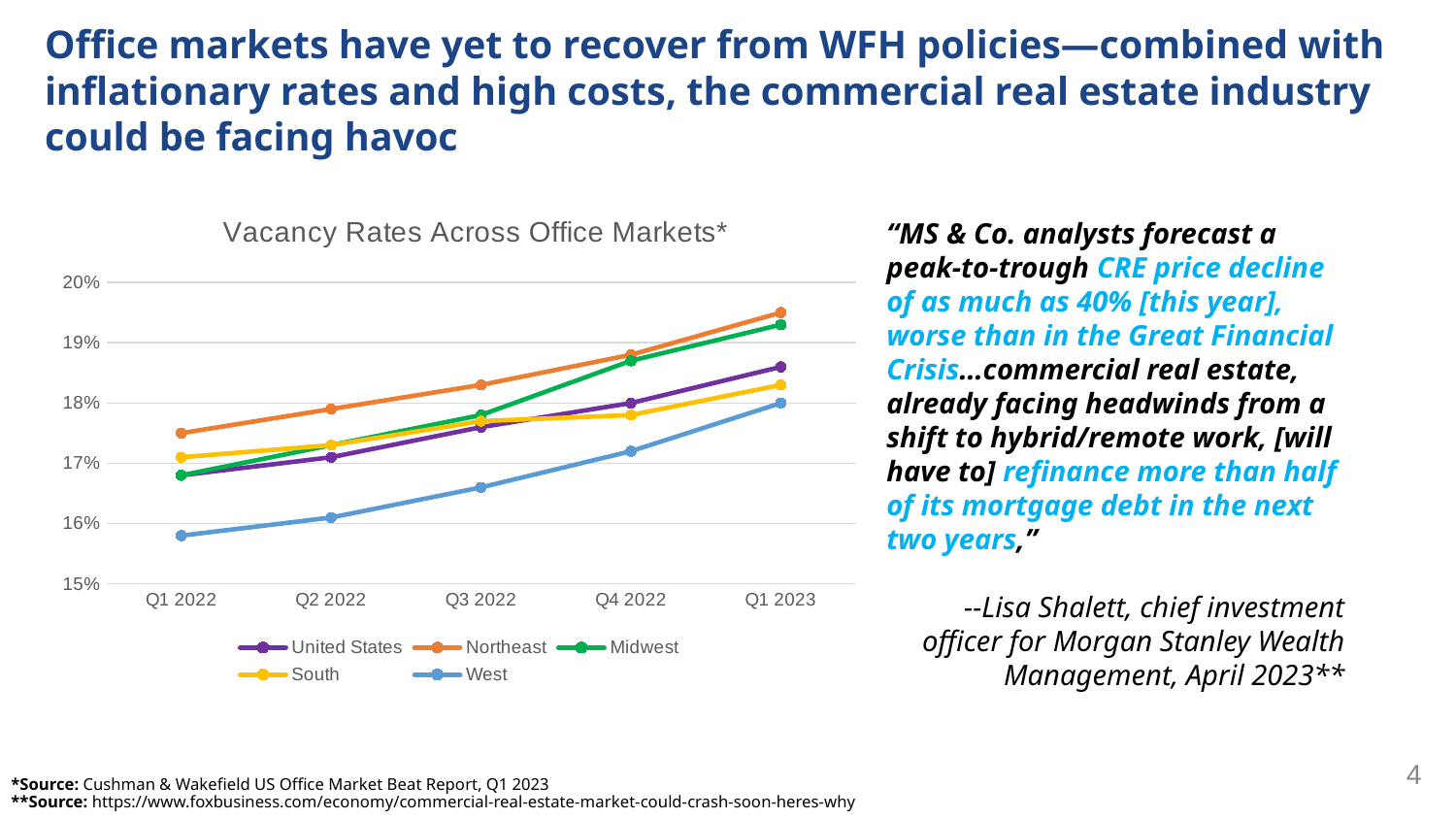
Does the vacancy rate for West rise or fall from Q1 2022 to Q1 2023? rise Is the vacancy rate for West in Q3 2022 greater or less than 17%? less What kind of chart is shown on the slide? line chart Is the vacancy rate for United States in Q1 2023 greater or less than 18%? greater What is the title of the chart? Vacancy Rates Across Office Markets* Which region has the lowest vacancy rate in Q1 2022? West In Q1 2022, which has the higher vacancy rate, Northeast or West? Northeast How many series does the legend list? 5 How many time periods are shown on the x axis? 5 Is the vacancy rate for Northeast in Q1 2023 greater or less than 19%? greater Which region has the highest vacancy rate in Q1 2023? Northeast